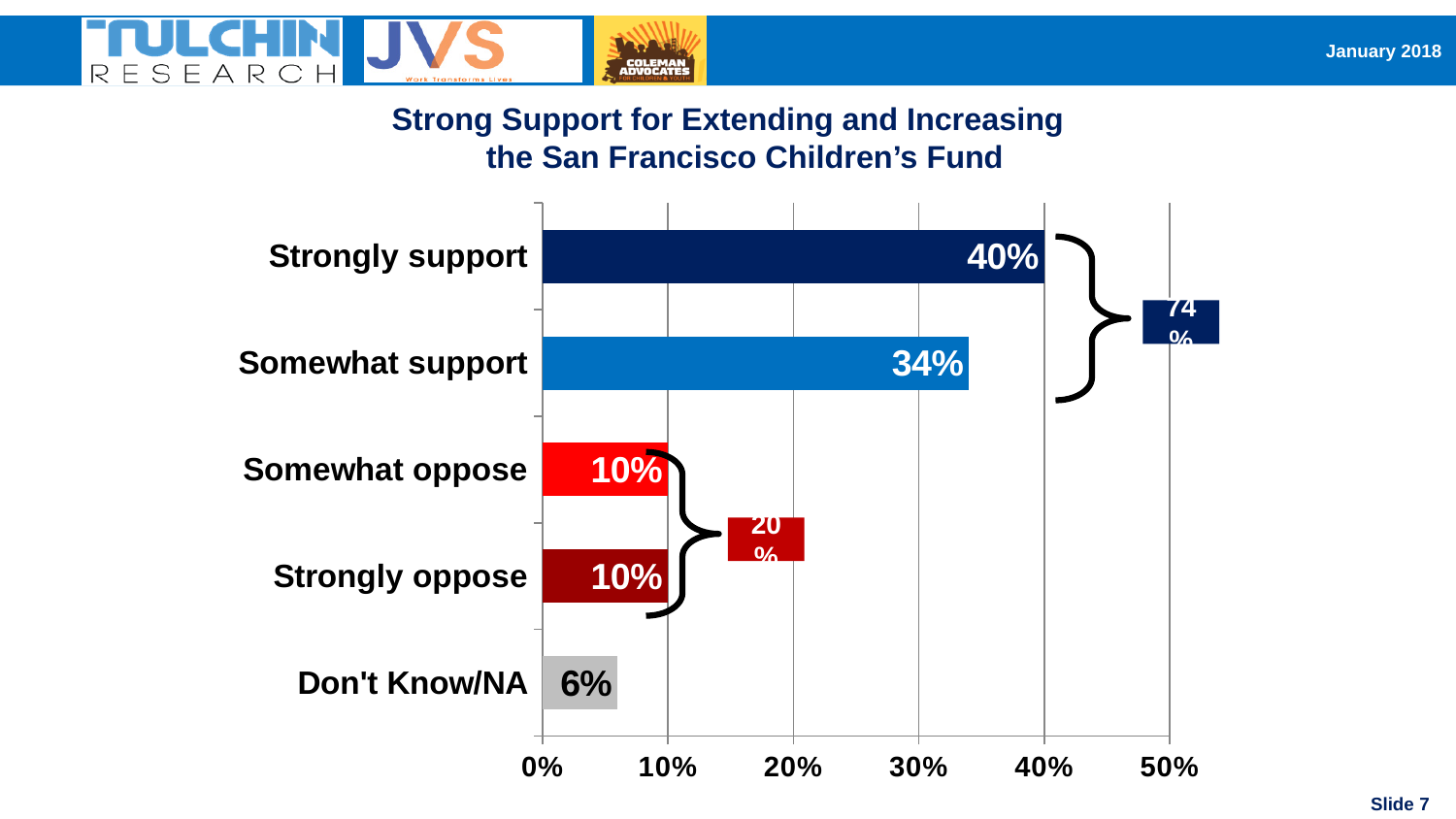
What is the value for Don't Know/NA? 6% What is the combined value of Strongly support and Somewhat support? 74% What is the title of the chart? Strong Support for Extending and Increasing the San Francisco Children's Fund Which category has the lowest value? Don't Know/NA What is the value for Strongly oppose? 10% Which is larger, Somewhat support or Somewhat oppose? Somewhat support Which category has the highest value? Strongly support What is the value for Somewhat support? 34% What is the difference between Strongly support and Somewhat support? 6% What is the value for Strongly support? 40% How many categories are shown in the chart? 5 What kind of chart is shown on the slide? Bar chart